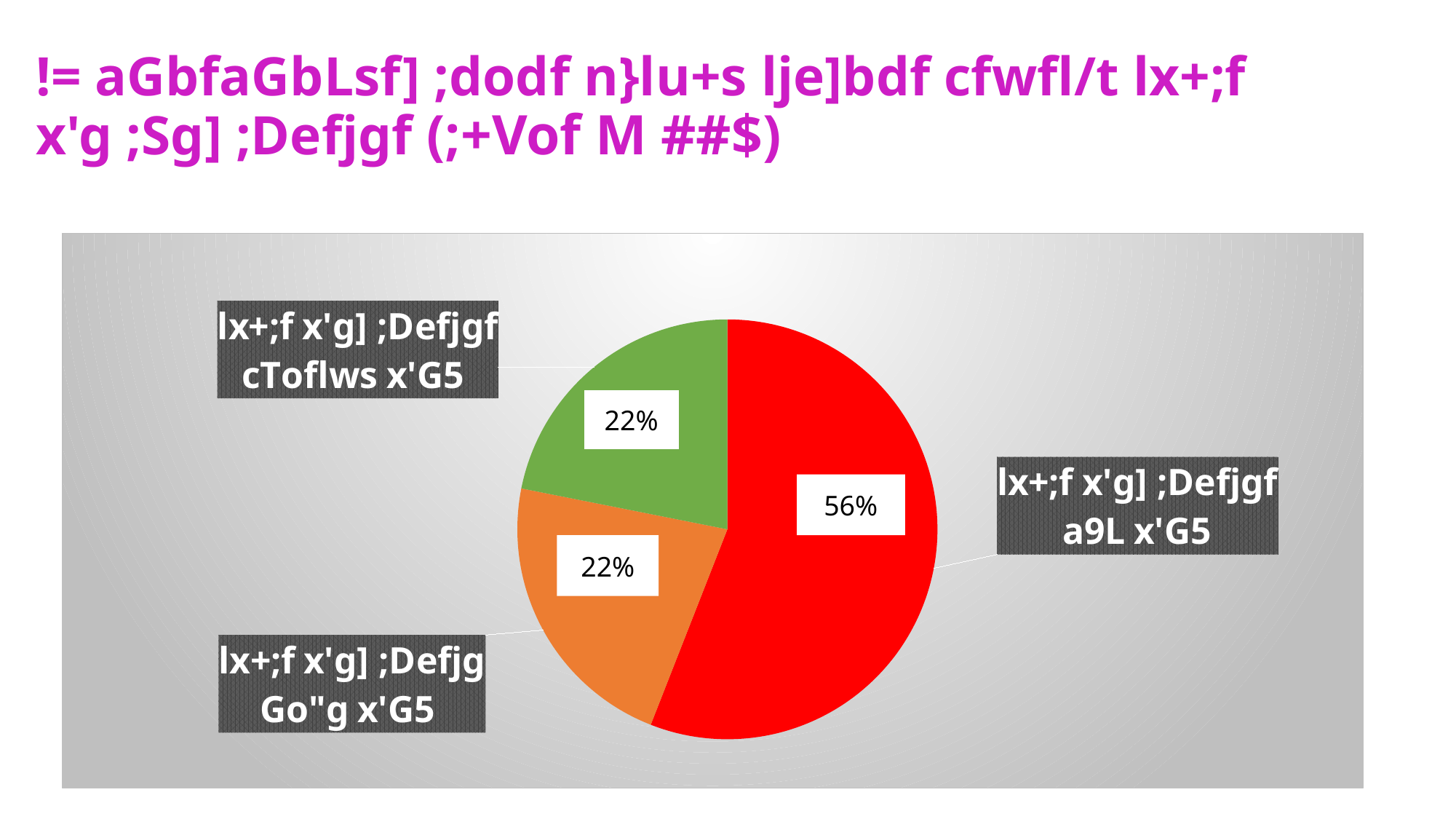
What colour is the slice labelled "lx+;f x'g] ;Defjgf cToflws x'G5"? green Is the share of the red slice greater or less than 50%? greater Which is larger: the red slice or the green slice? the red slice Which slice of the pie chart is the largest? lx+;f x'g] ;Defjgf a9L x'G5 (red, 56%) What is the difference in percentage points between the red slice (56%) and the orange slice (22%)? 34 What share of the pie does the green slice (labelled "lx+;f x'g] ;Defjgf cToflws x'G5") represent? 22% Do the green and orange slices have the same percentage value? yes, both 22% What kind of chart is shown on the slide? pie chart What share of the pie does the red slice (labelled "lx+;f x'g] ;Defjgf a9L x'G5") represent? 56% What is the combined share of the green and orange slices? 44% What share of the pie does the orange slice (labelled "lx+;f x'g] ;Defjg Go"g x'G5") represent? 22% How many slices does the pie chart have? 3